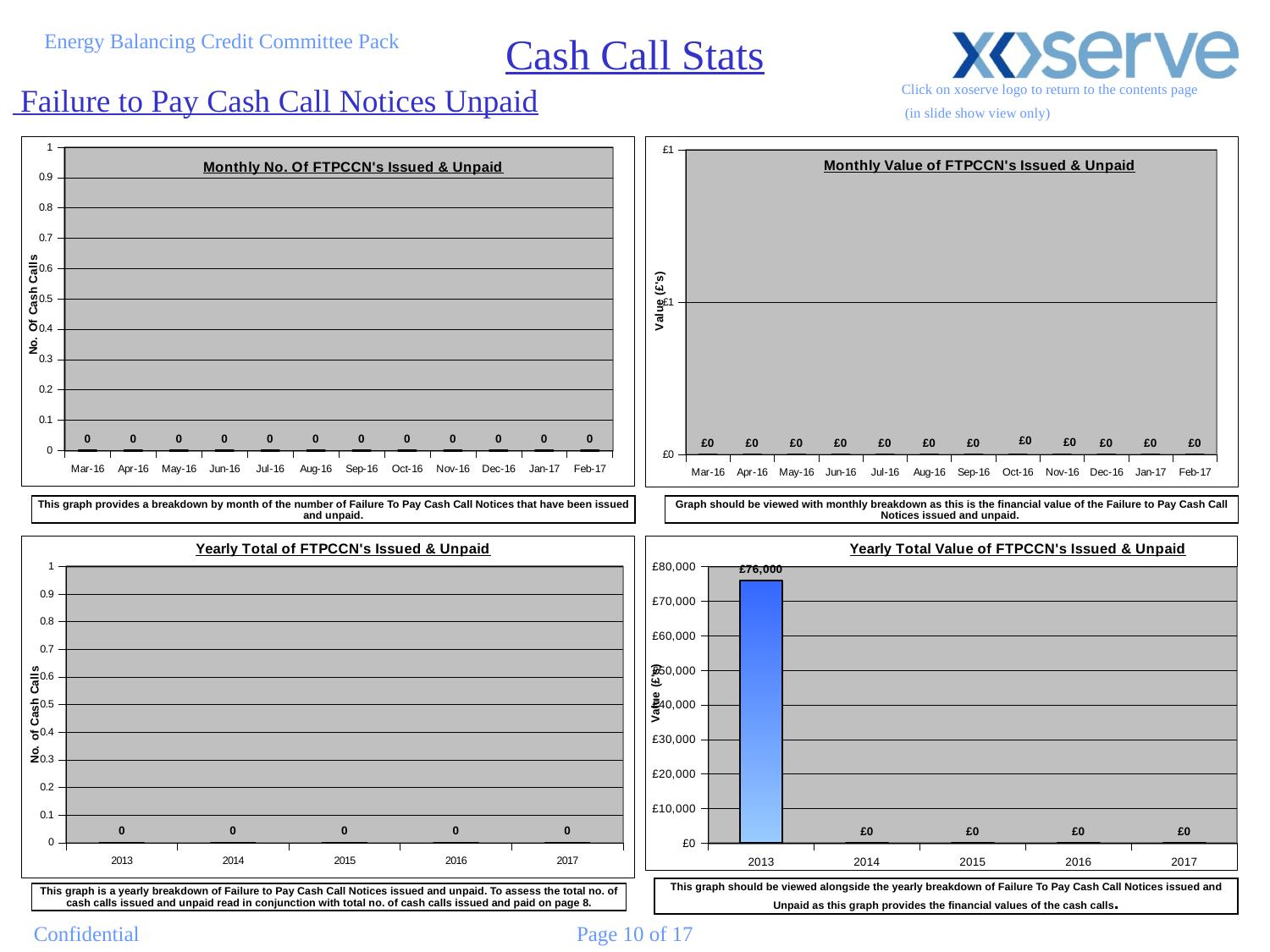
In the 'Monthly Value of FTPCCN's Issued & Unpaid' chart, what is the value for Jan-17? £0 In the 'Yearly Total Value of FTPCCN's Issued & Unpaid' chart, is the value for 2013 greater or less than £70,000? greater In the 'Yearly Total Value of FTPCCN's Issued & Unpaid' chart, what is the value for 2015? £0 What kind of chart is the 'Yearly Total Value of FTPCCN's Issued & Unpaid' chart? bar chart In the 'Yearly Total Value of FTPCCN's Issued & Unpaid' chart, which year has the highest value? 2013 In the 'Monthly No. Of FTPCCN's Issued & Unpaid' chart, what is the value for Oct-16? 0 In the 'Yearly Total Value of FTPCCN's Issued & Unpaid' chart, which is larger, the value for 2013 or the value for 2017? 2013 In the 'Yearly Total Value of FTPCCN's Issued & Unpaid' chart, what is the value for 2013? £76,000 In the 'Yearly Total of FTPCCN's Issued & Unpaid' chart, what is the value for 2016? 0 How many years are shown on the x axis of the 'Yearly Total of FTPCCN's Issued & Unpaid' chart? 5 How many months are shown on the x axis of the 'Monthly Value of FTPCCN's Issued & Unpaid' chart? 12 In the 'Yearly Total Value of FTPCCN's Issued & Unpaid' chart, what is the difference between the values for 2013 and 2014? £76,000